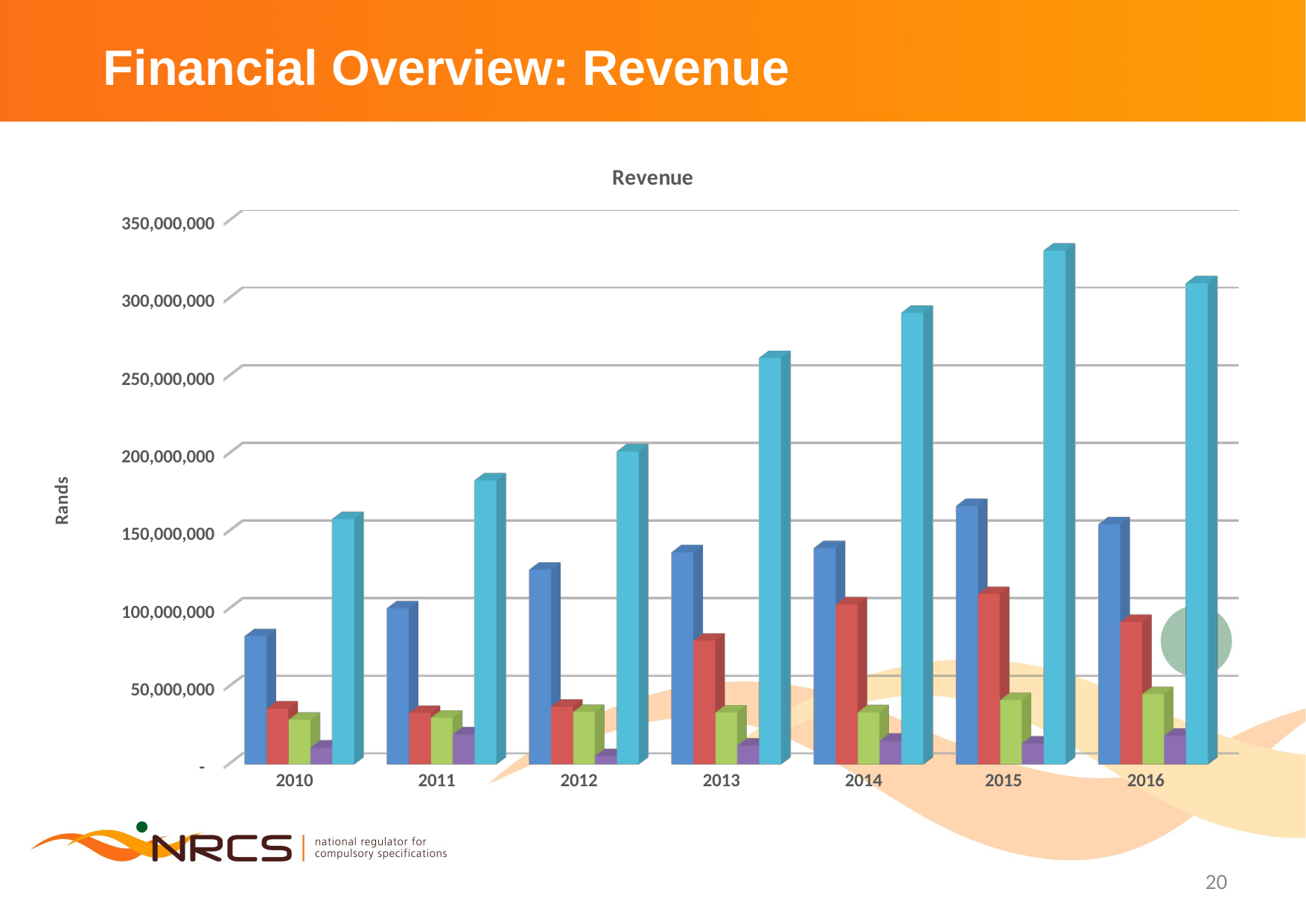
Is the light blue bar for 2013 greater or less than 250,000,000? greater In which year is the light blue bar the shortest? 2010 Does the light blue series rise or fall from 2010 to 2015? rise What type of chart is shown on the slide? Bar chart How many bars are plotted for each year in the chart? 5 Which is larger, the light blue bar for 2015 or the light blue bar for 2016? 2015 What is the label on the vertical axis of the chart? Rands Is the dark blue bar for 2012 greater or less than 100,000,000? greater Is the red bar for 2013 greater or less than 50,000,000? greater How many years are shown along the x axis of the chart? 7 What is the title of the chart? Revenue In which year is the light blue bar the tallest? 2015